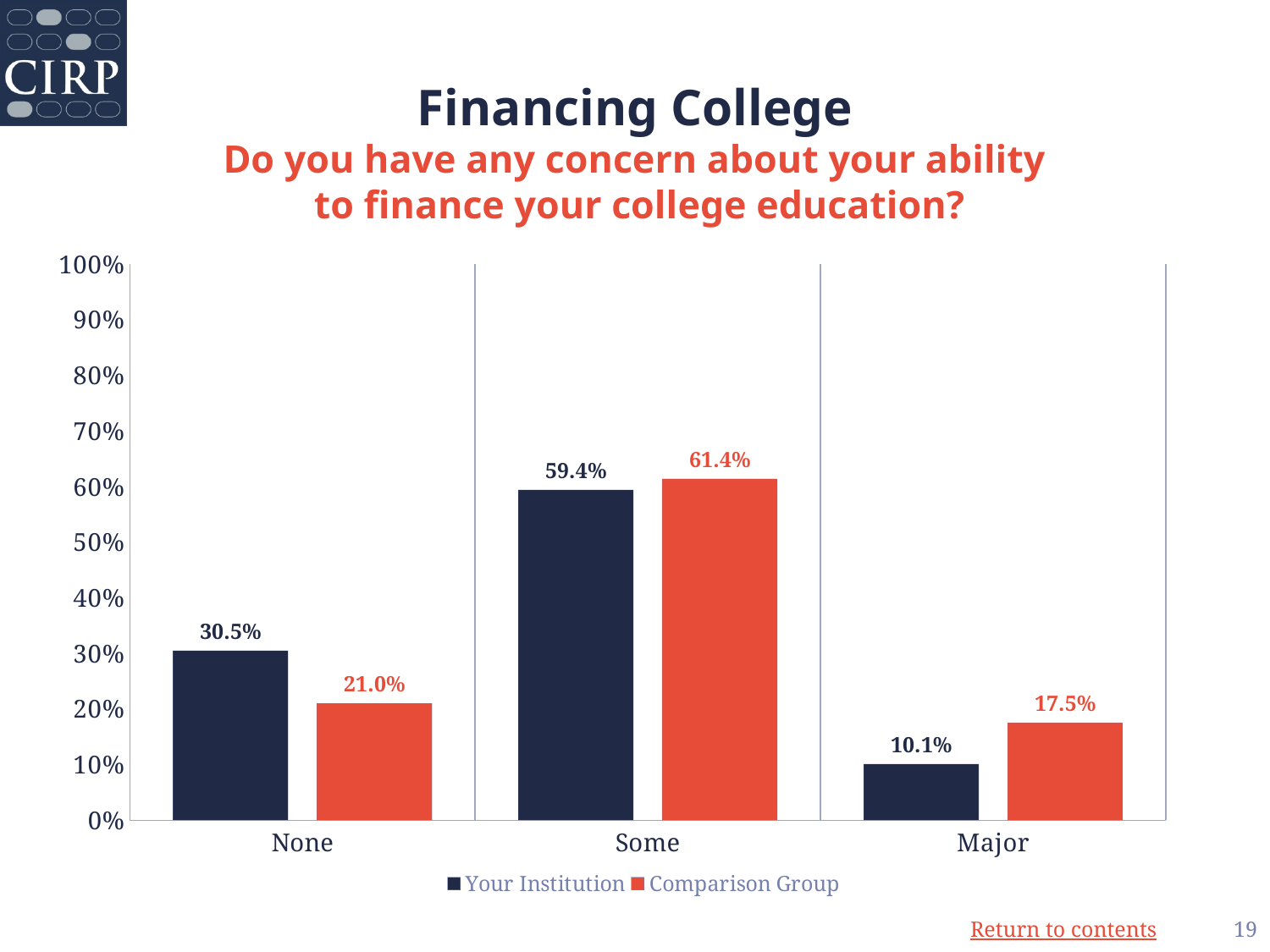
What is the value for Comparison Group in the Major category? 17.5% What is the difference between Comparison Group and Your Institution in the Major category? 7.4% What is the value for Your Institution in the None category? 30.5% Which category has the highest value for Your Institution? Some How many categories are shown on the x axis? 3 Which is larger in the Some category, Your Institution or Comparison Group? Comparison Group Is the value for Your Institution in the Major category greater or less than 20%? less What is the difference between Your Institution and Comparison Group in the None category? 9.5% What is the value for Comparison Group in the Some category? 61.4% What kind of chart is shown on the slide? bar chart How many series does the legend list? 2 Which category has the lowest value for Comparison Group? Major